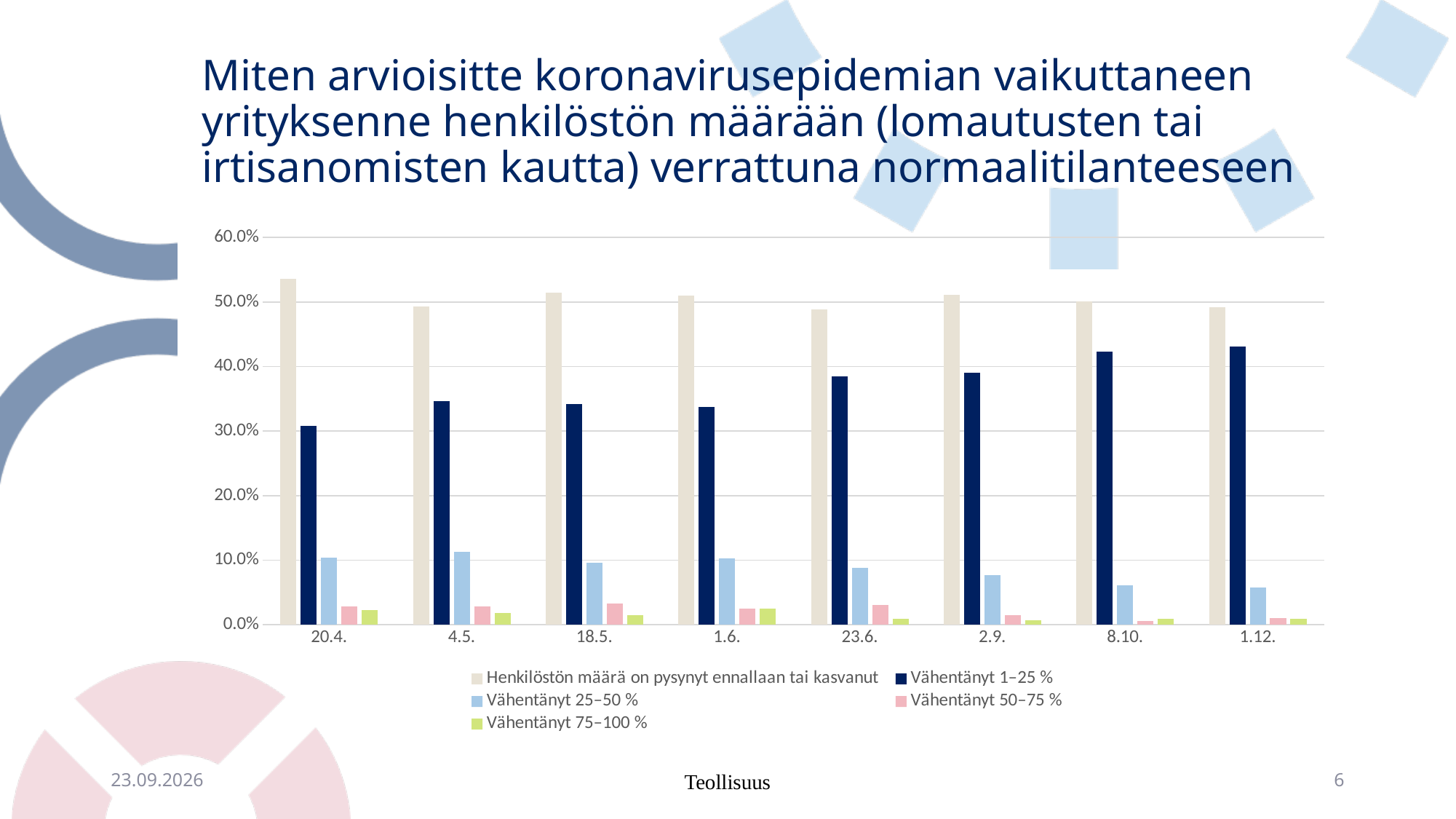
How many series does the chart's legend list? 5 Is the value for 'Vähentänyt 25–50 %' on 4.5. greater or less than 10.0%? greater Does the value for 'Vähentänyt 25–50 %' generally rise or fall from 20.4. to 1.12.? fall Is the value for 'Vähentänyt 25–50 %' on 1.12. greater or less than 10.0%? less On which date is the value for 'Vähentänyt 1–25 %' lowest? 20.4. On which date is the value for 'Henkilöstön määrä on pysynyt ennallaan tai kasvanut' highest? 20.4. What kind of chart is shown on the slide? bar chart How many dates are shown on the x axis of the chart? 8 Is the value for 'Henkilöstön määrä on pysynyt ennallaan tai kasvanut' on 20.4. greater or less than 50.0%? greater What colour represents 'Vähentänyt 75–100 %' in the legend? green On 20.4., which is larger: 'Henkilöstön määrä on pysynyt ennallaan tai kasvanut' or 'Vähentänyt 1–25 %'? Henkilöstön määrä on pysynyt ennallaan tai kasvanut